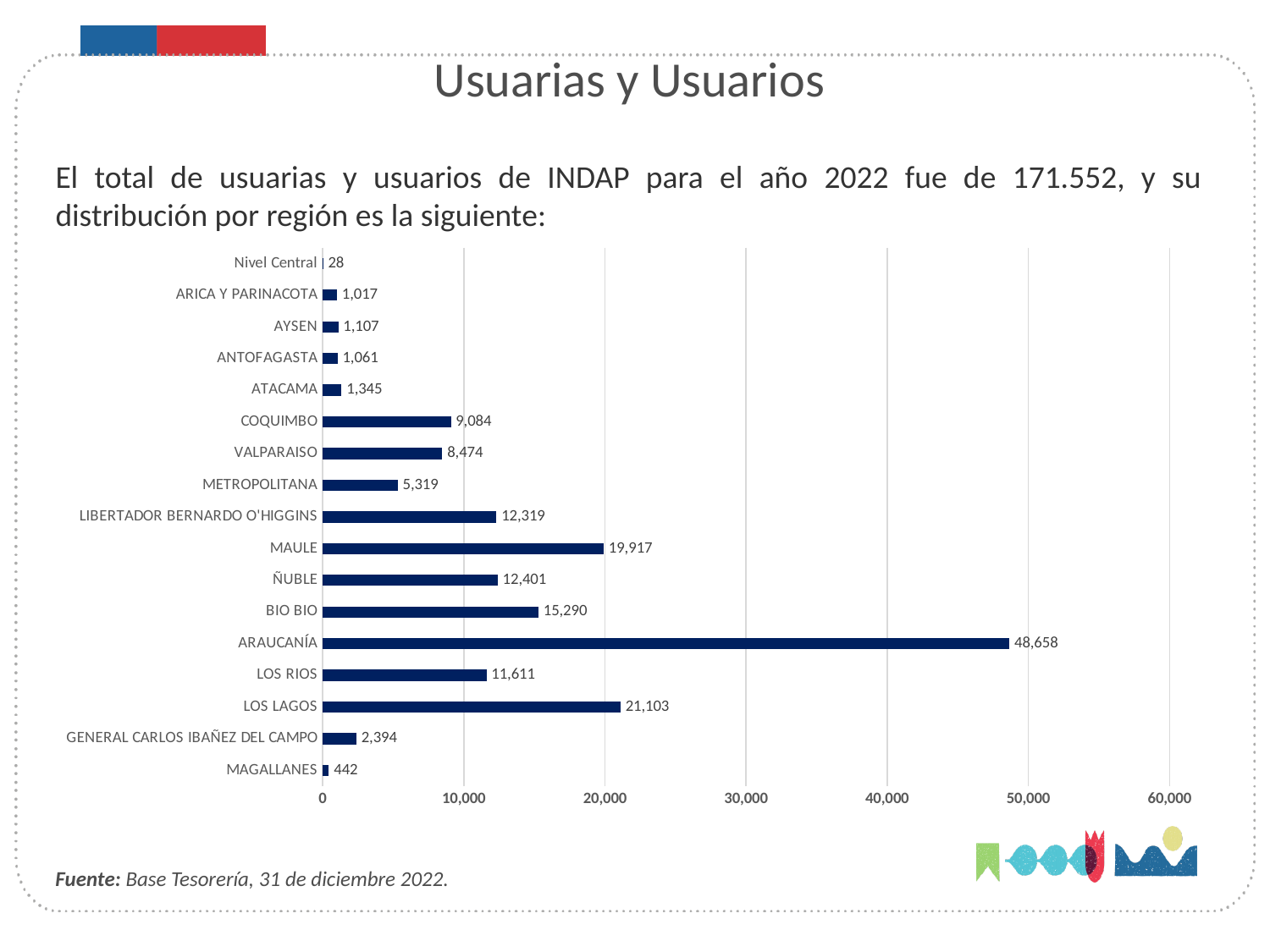
Which is larger, the value for BIO BIO or the value for LOS RIOS? BIO BIO What is the value for Nivel Central? 28 What is the value for GENERAL CARLOS IBAÑEZ DEL CAMPO? 2,394 Is the value for ARAUCANÍA greater or less than 40,000? greater What kind of chart is shown on the slide? bar chart What is the difference between the values for ARAUCANÍA and BIO BIO? 33,368 What is the difference between the values for COQUIMBO and VALPARAISO? 610 Which category has the lowest value? Nivel Central What is the value for ARAUCANÍA? 48,658 Which category has the highest value? ARAUCANÍA How many categories are shown in the chart? 17 What is the value for LOS LAGOS? 21,103